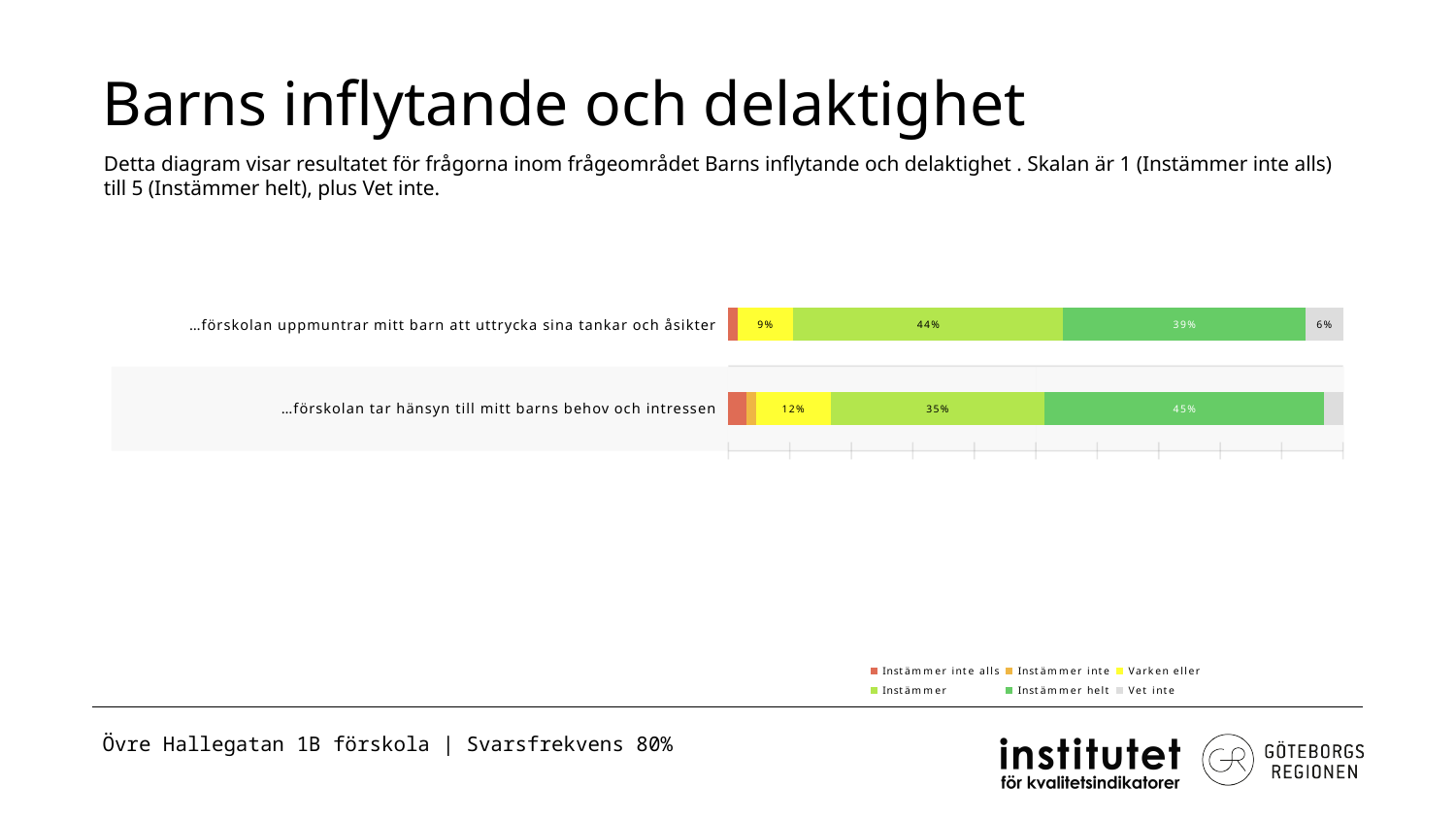
What is the 'Instämmer helt' value for '…förskolan tar hänsyn till mitt barns behov och intressen'? 45% How many categories (questions) are plotted in the chart? 2 What is the 'Instämmer' value for '…förskolan uppmuntrar mitt barn att uttrycka sina tankar och åsikter'? 44% What is the difference between the 'Instämmer' values of the two categories? 9% What is the 'Varken eller' value for '…förskolan tar hänsyn till mitt barns behov och intressen'? 12% Which category has the higher 'Instämmer' value? …förskolan uppmuntrar mitt barn att uttrycka sina tankar och åsikter Which legend entry is shown in yellow? Varken eller What kind of chart is shown on the slide? bar chart What is the difference between the 'Varken eller' values of the two categories? 3% How many series does the legend list? 6 Which category has the higher 'Instämmer helt' value? …förskolan tar hänsyn till mitt barns behov och intressen What is the 'Vet inte' value for '…förskolan uppmuntrar mitt barn att uttrycka sina tankar och åsikter'? 6%